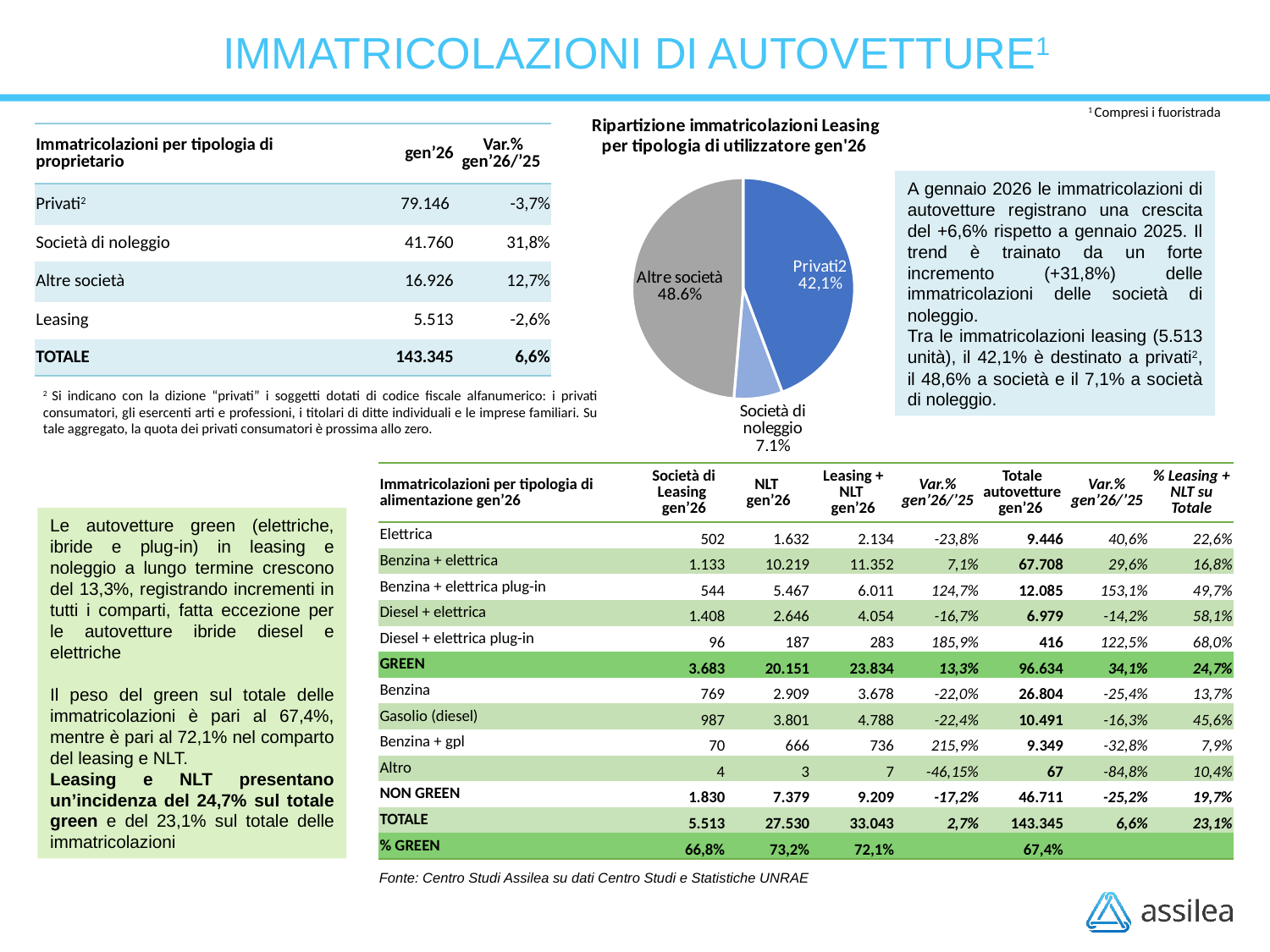
In the pie chart, what share is shown for Altre società? 48.6% In the pie chart, which is larger: the share for Privati or the share for Società di noleggio? Privati Which slice of the pie chart is the smallest? Società di noleggio Which slice of the pie chart is the largest? Altre società In the pie chart, what share is shown for Società di noleggio? 7.1% What kind of chart is shown under the title "Ripartizione immatricolazioni Leasing per tipologia di utilizzatore gen'26"? pie chart In the pie chart, what is the difference in percentage points between the Privati share and the Società di noleggio share? 35 percentage points How many slices does the pie chart have? 3 In the pie chart, what colour is the Altre società slice? grey What is the title of the pie chart? Ripartizione immatricolazioni Leasing per tipologia di utilizzatore gen'26 In the pie chart, what is the difference in percentage points between the Altre società share and the Privati share? 6.5 percentage points In the pie chart, what share is shown for Privati? 42,1%